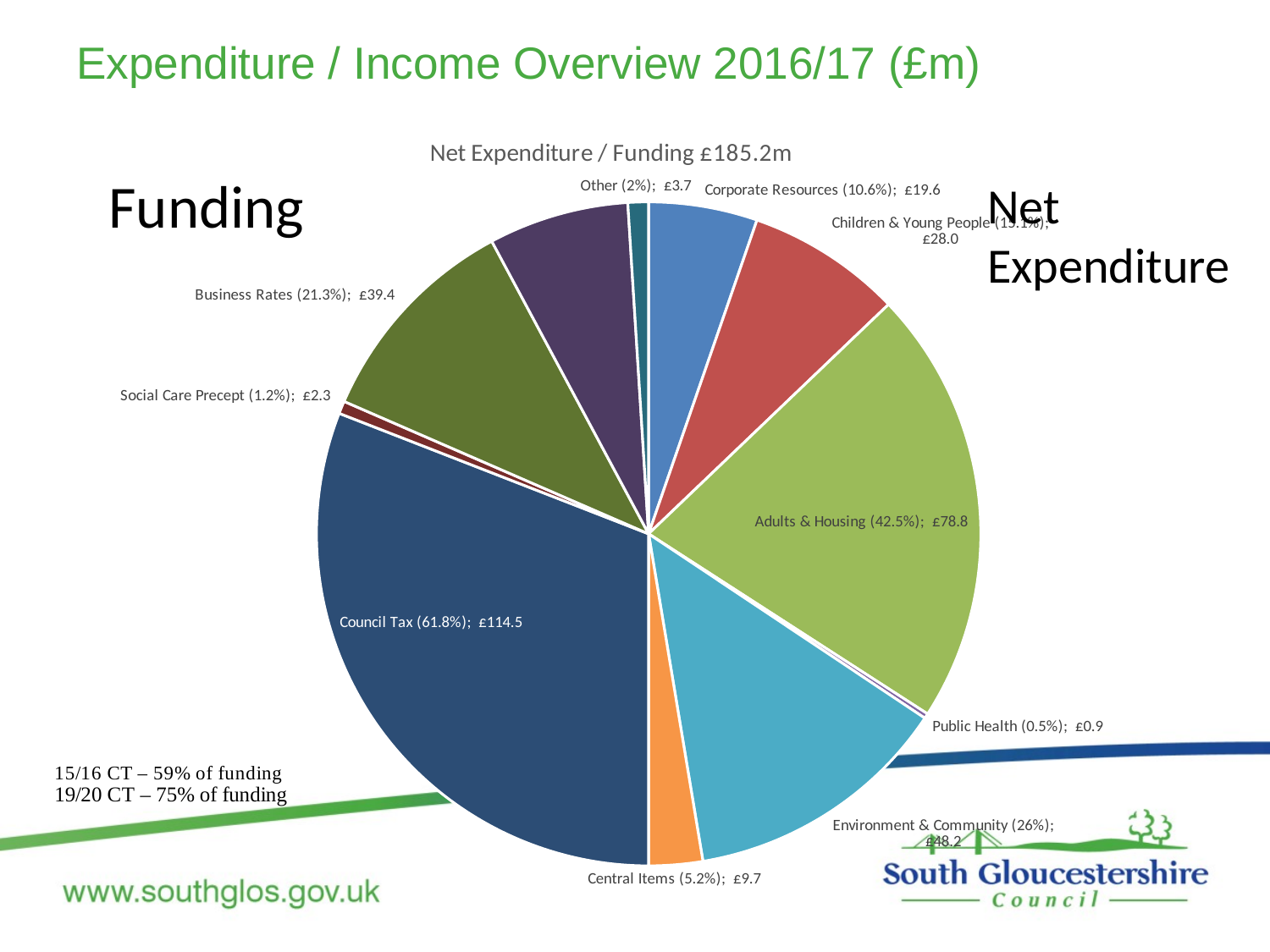
What is the value shown for Business Rates in the pie chart? £39.4 Which slice of the pie chart has the largest value? Council Tax What is the title of the chart? Net Expenditure / Funding £185.2m What is the difference between the Adults & Housing value and the Environment & Community value? £30.6 What is the value shown for Children & Young People in the pie chart? £28.0 What is the value shown for Council Tax in the pie chart? £114.5 How many slices does the pie chart have? 11 What percentage share of the pie does Adults & Housing represent? 42.5% Which slice of the pie chart has the smallest value? Public Health What is the value shown for Adults & Housing in the pie chart? £78.8 Which is larger, Corporate Resources or Central Items? Corporate Resources What is the difference between the Council Tax value and the Business Rates value? £75.1